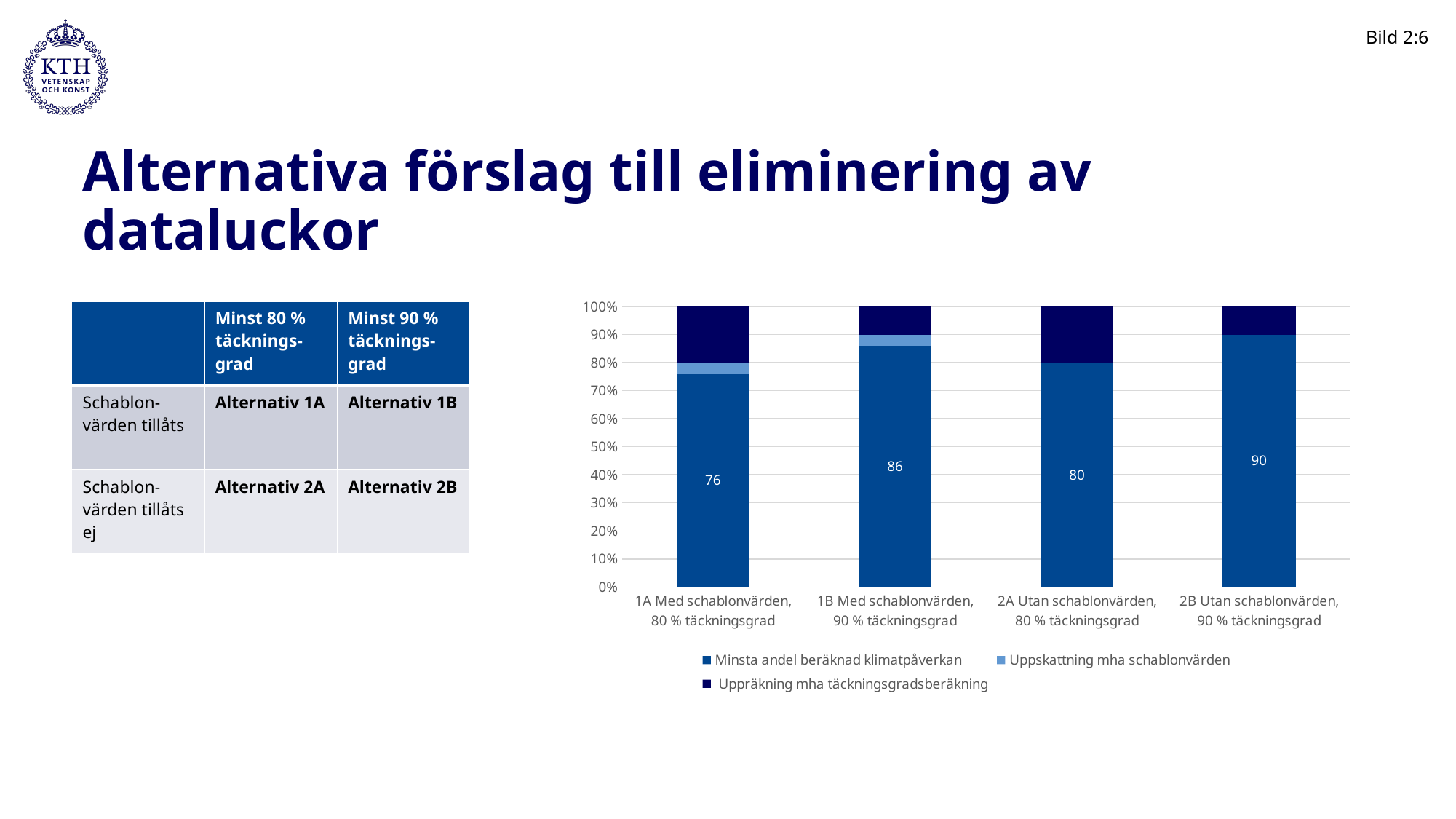
Which has a larger 'Minsta andel beräknad klimatpåverkan' value, 1B or 2A? 1B Med schablonvärden, 90 % täckningsgrad Which category has the highest value for 'Minsta andel beräknad klimatpåverkan'? 2B Utan schablonvärden, 90 % täckningsgrad Which category has the lowest value for 'Minsta andel beräknad klimatpåverkan'? 1A Med schablonvärden, 80 % täckningsgrad What is the difference between the 'Minsta andel beräknad klimatpåverkan' values for 2B and 1A? 14 Is the 'Uppräkning mha täckningsgradsberäkning' segment for '2A Utan schablonvärden, 80 % täckningsgrad' greater or less than 10%? greater What is the value of the 'Minsta andel beräknad klimatpåverkan' segment for '1B Med schablonvärden, 90 % täckningsgrad'? 86 How many series does the chart legend list? 3 What is the value of the 'Minsta andel beräknad klimatpåverkan' segment for '1A Med schablonvärden, 80 % täckningsgrad'? 76 What kind of chart is shown on the slide? Stacked bar chart What is the value of the 'Minsta andel beräknad klimatpåverkan' segment for '2B Utan schablonvärden, 90 % täckningsgrad'? 90 How many categories are shown on the x axis of the chart? 4 What is the value of the 'Minsta andel beräknad klimatpåverkan' segment for '2A Utan schablonvärden, 80 % täckningsgrad'? 80